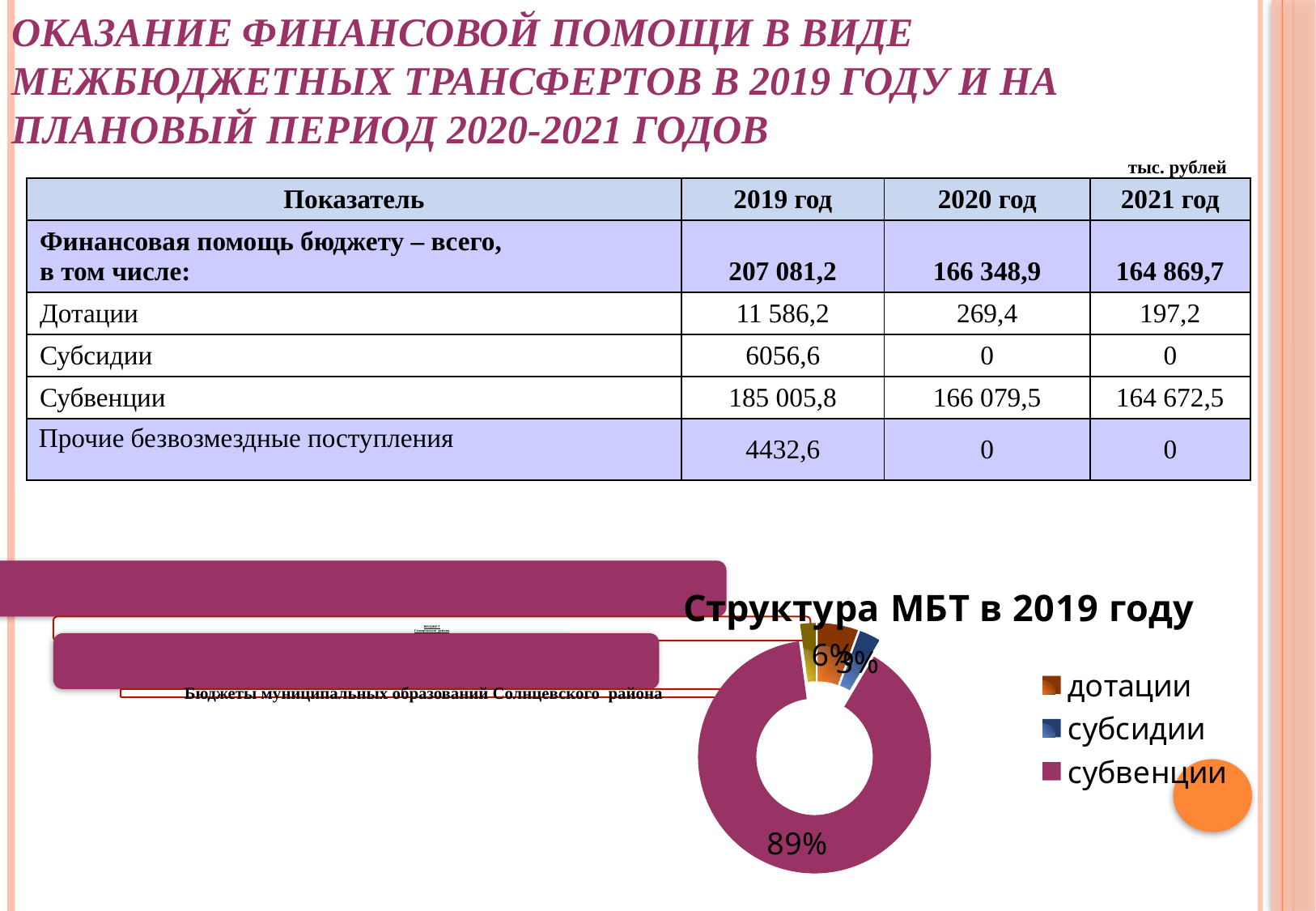
What is the difference in percentage points between the share of субвенции and the share of дотации? 83% What share of the chart does субсидии take? 3% How many entries does the chart's legend list? 3 What kind of chart is shown on the slide? doughnut chart What share of the chart does дотации take? 6% What share of the chart does субвенции take? 89% Which category has the smallest share among the legend entries in the chart? субсидии What is the title of the chart on the slide? Структура МБТ в 2019 году Is the share of субвенции greater or less than 50%? greater Which is larger in the chart, дотации or субсидии? дотации Which category has the largest share in the chart? субвенции Which colour represents субвенции in the chart? purple